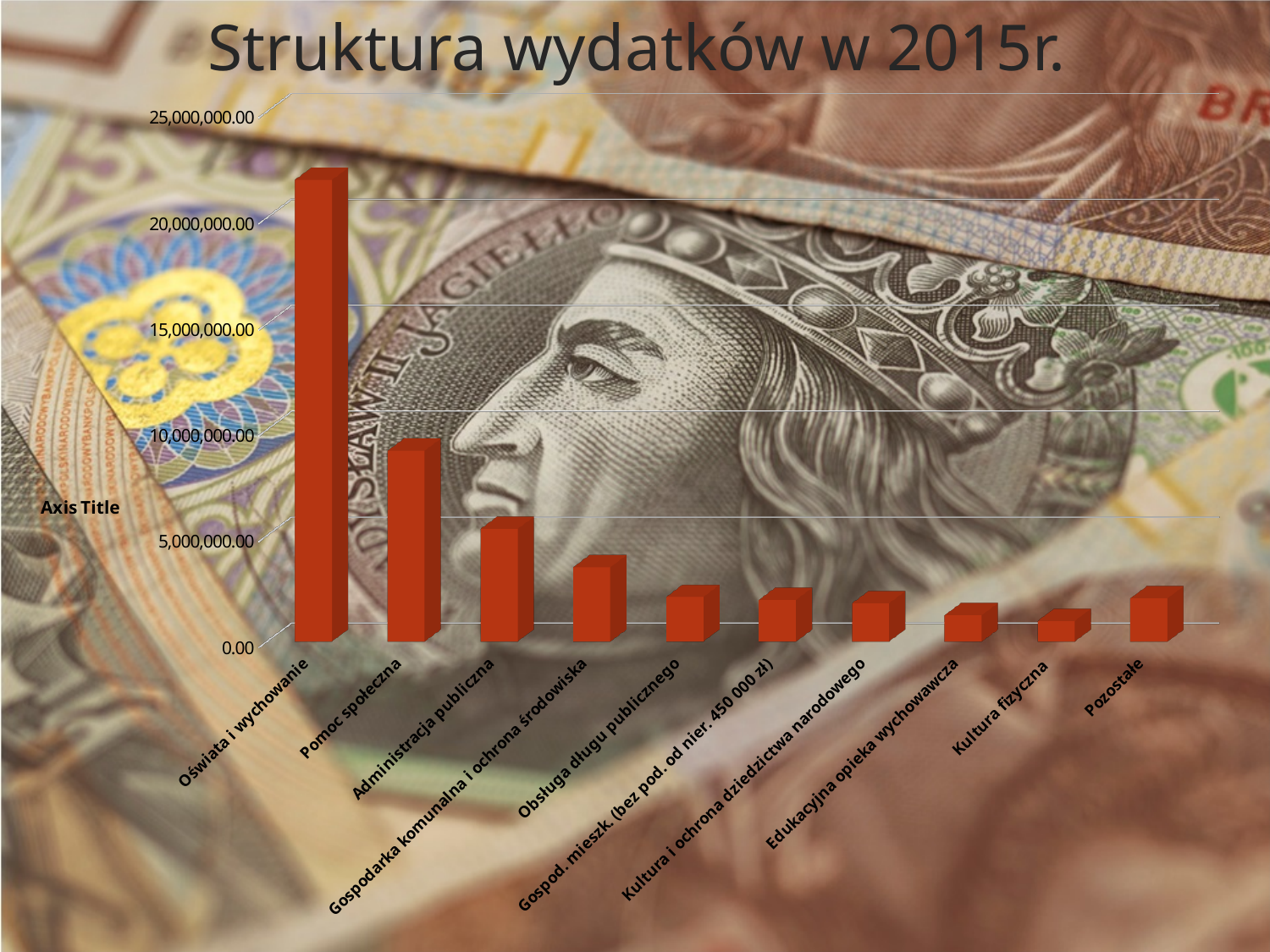
What is the title of the chart? Struktura wydatków w 2015r. What kind of chart is shown on the slide? bar chart What label is shown on the vertical axis of the chart? Axis Title Which category has the lowest value? Kultura fizyczna Is the value for Gospodarka komunalna i ochrona środowiska greater or less than 5,000,000.00? less Which category has the highest value? Oświata i wychowanie Which is larger, the value for Pozostałe or the value for Kultura fizyczna? Pozostałe How many categories are shown on the x axis of the chart? 10 Is the value for Administracja publiczna greater or less than 5,000,000.00? greater Is the value for Oświata i wychowanie greater or less than 20,000,000.00? greater Which is larger, the value for Pomoc społeczna or the value for Administracja publiczna? Pomoc społeczna